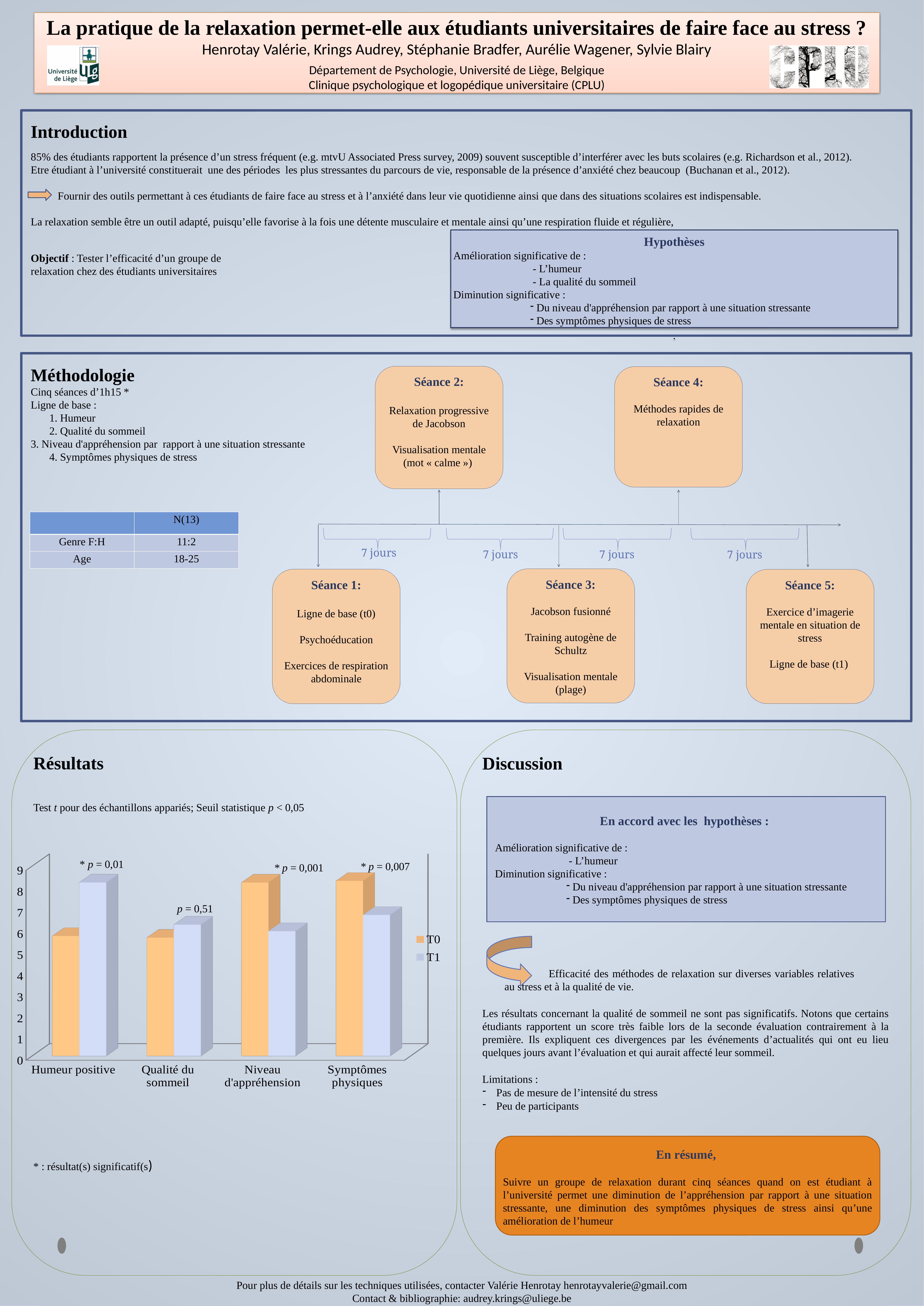
How many categories are shown on the x axis of the bar chart? 4 Which colour represents the T0 series in the bar chart? orange What p-value is printed above the Niveau d'appréhension bars? * p = 0,001 What p-value is printed above the Humeur positive bars? * p = 0,01 For Niveau d'appréhension, which is larger, T0 or T1? T0 What are the two series named in the legend of the bar chart? T0 and T1 What p-value is printed above the Qualité du sommeil bars? p = 0,51 Is the T1 value for Humeur positive greater or less than 7? greater What p-value is printed above the Symptômes physiques bars? * p = 0,007 For Humeur positive, which is larger, T0 or T1? T1 What kind of chart is shown in the Résultats section? bar chart How many series does the legend of the bar chart list? 2